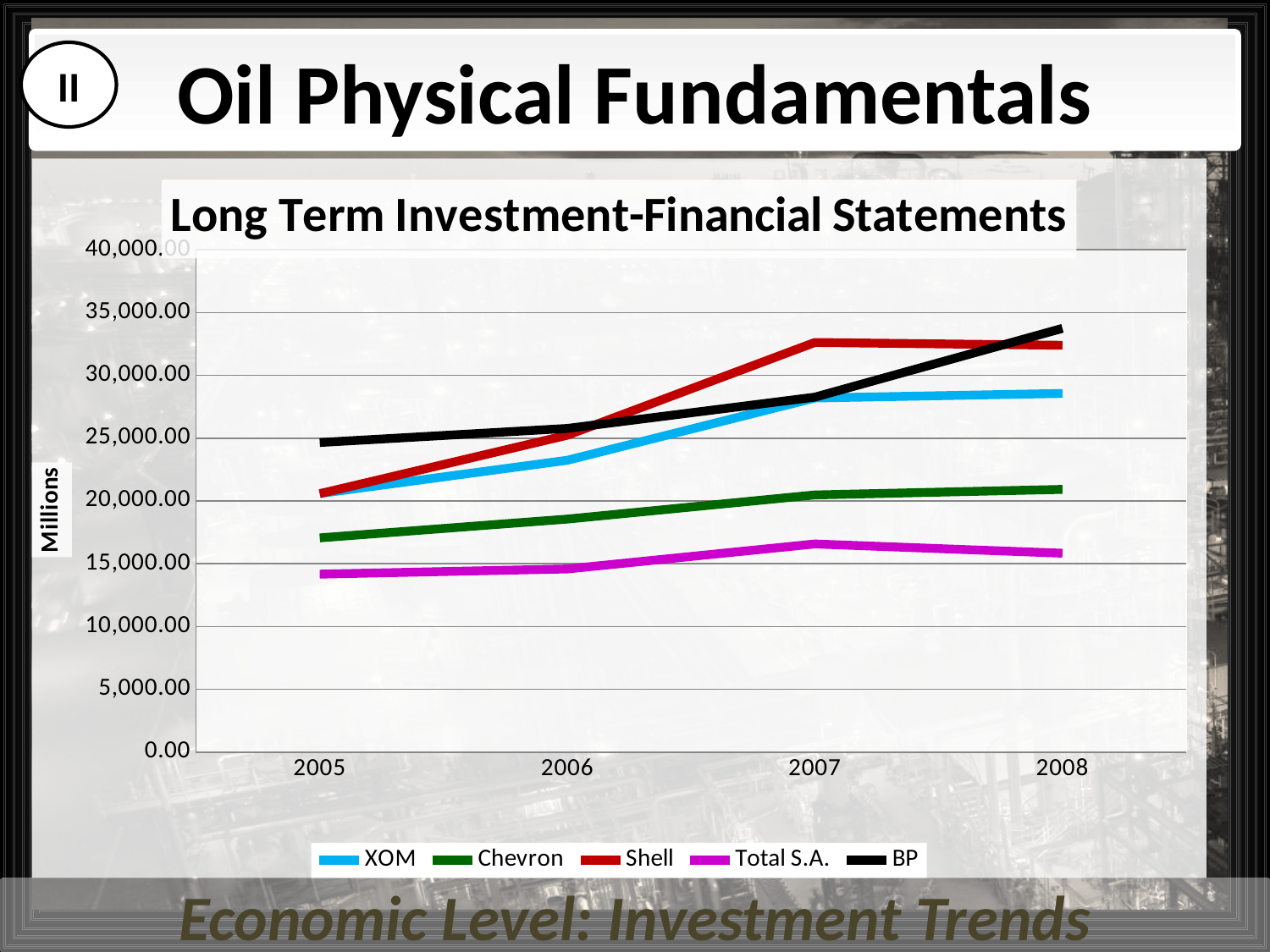
Which company has the highest value in 2005? BP Which company has the lowest value in 2008? Total S.A. What is the title of the chart? Long Term Investment-Financial Statements How many series does the legend list? 5 Does the value for Chevron rise or fall from 2005 to 2008? Rise In 2007, which is larger, the value for Shell or the value for Chevron? Shell What kind of chart is shown on the slide? Line chart Which company has the highest value in 2008? BP How many years are shown on the x axis? 4 Is the value for Total S.A. in 2005 greater or less than 15,000.00? less Is the value for Shell in 2007 greater or less than 30,000.00? greater Is the value for BP in 2008 greater or less than 30,000.00? greater